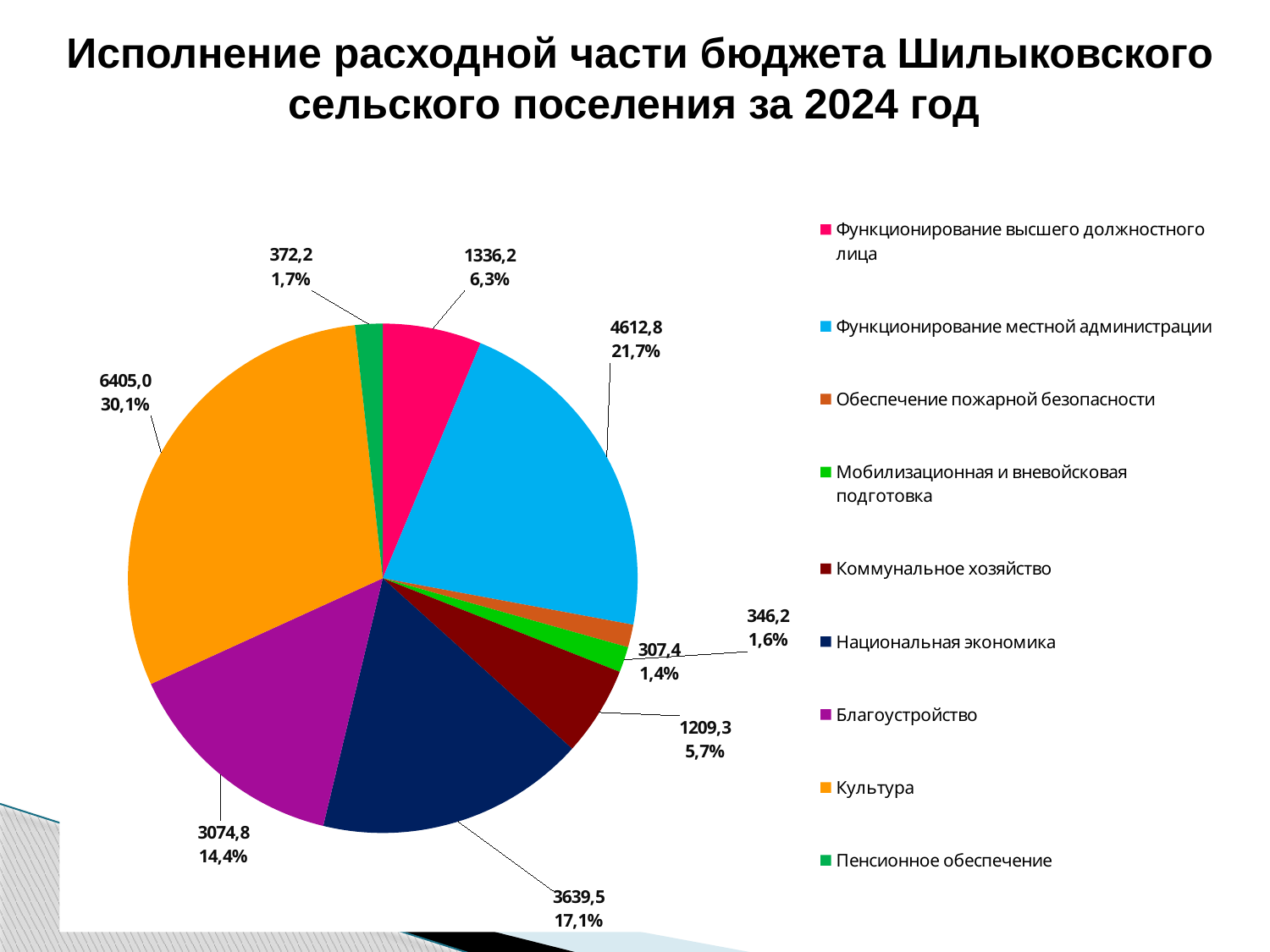
Which is larger, the value for Национальная экономика or the value for Благоустройство? Национальная экономика What type of chart is shown on the slide? pie chart What value is shown for Культура? 6405,0 What value is shown for Национальная экономика? 3639,5 How many entries does the legend list? 9 What is the title of the slide? Исполнение расходной части бюджета Шилыковского сельского поселения за 2024 год Which category has the largest slice? Культура What is the difference between the values for Культура and Функционирование местной администрации? 1792,2 What share of the pie does Функционирование местной администрации have? 21,7% What share of the pie does Благоустройство have? 14,4% How many slices does the pie chart have? 9 Which category has the smallest slice? Обеспечение пожарной безопасности